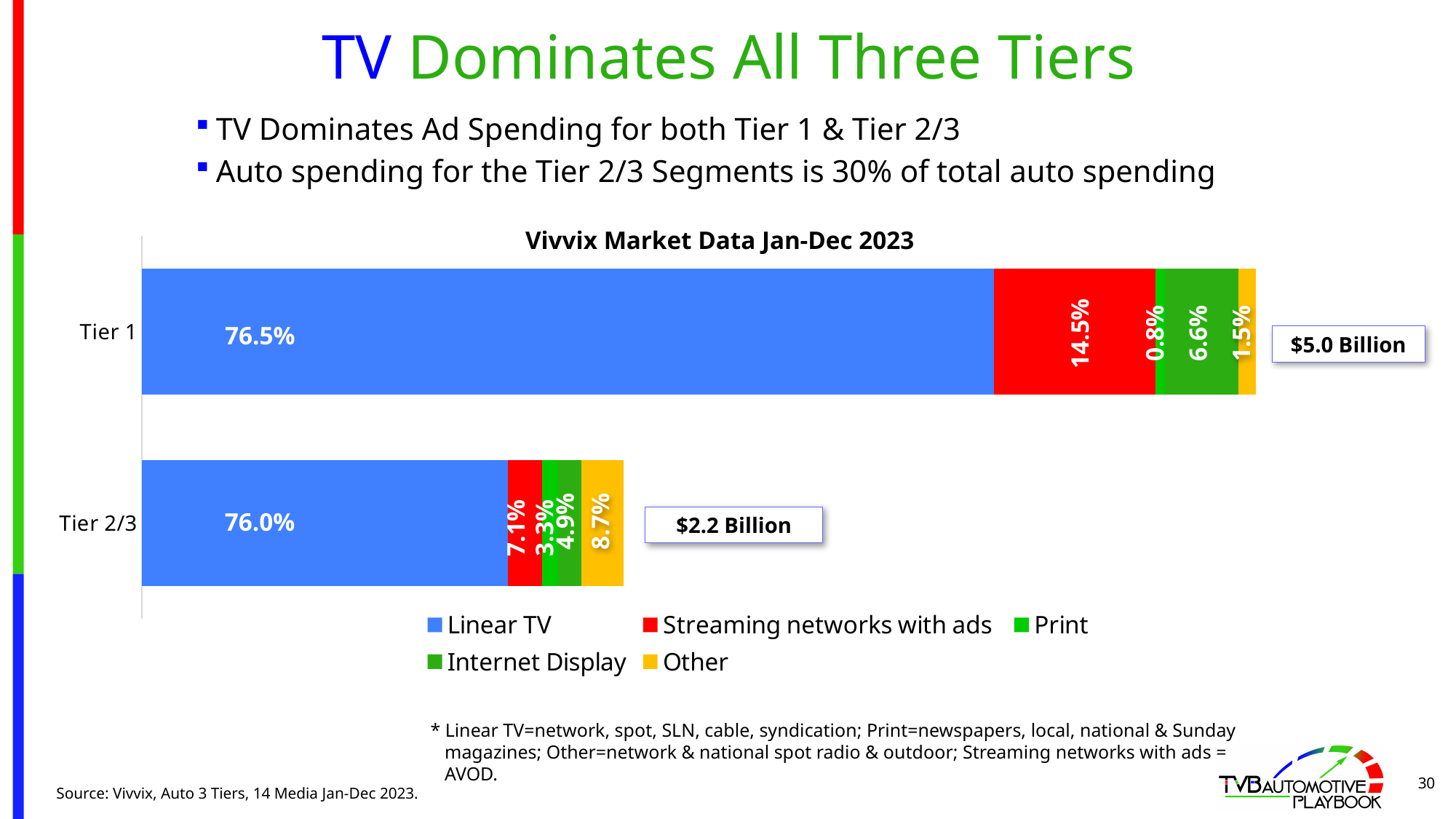
What is the Other share for Tier 2/3? 8.7% Which tier has the larger Streaming networks with ads share, Tier 1 or Tier 2/3? Tier 1 What type of chart is shown on the slide? Stacked bar chart Which media category has the largest share in the Tier 2/3 bar? Linear TV What is the Streaming networks with ads share for Tier 1? 14.5% What is the difference in percentage points between the Linear TV share for Tier 1 and for Tier 2/3? 0.5 percentage points Which media category has the smallest share in the Tier 1 bar? Print What percentage of Tier 1 ad spending goes to Linear TV? 76.5% What total dollar amount is shown next to the Tier 1 bar? $5.0 Billion What total dollar amount is shown next to the Tier 2/3 bar? $2.2 Billion How many tiers (bars) are plotted in the chart? 2 How many series does the legend list? 5